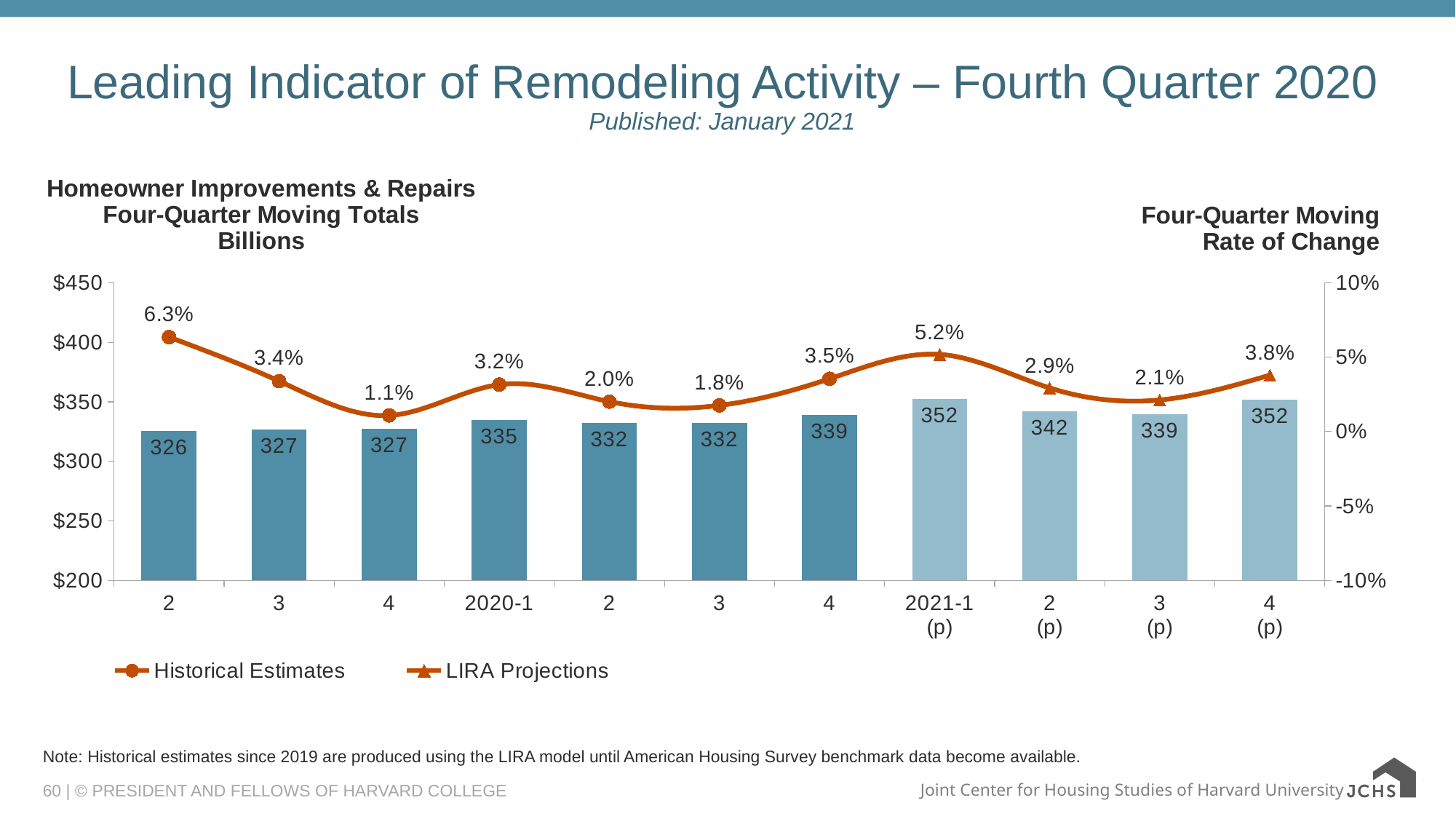
Which is larger, the four-quarter moving total for 2 (p) or for 3 (p)? 2 (p) What is the four-quarter moving rate of change for 2021-1 (p)? 5.2% What is the difference between the four-quarter moving totals for 2021-1 (p) and 2020-1? 17 What are the two series named in the legend? Historical Estimates and LIRA Projections How many quarters (bars) are shown on the chart? 11 What is the difference between the rate of change for 2021-1 (p) and the rate of change for 2 (p)? 2.3% What is the four-quarter moving total (in billions) for 4 (p), the last bar on the chart? 352 How many series does the legend list? 2 Which quarter has the highest four-quarter moving rate of change? 2 (the first quarter shown, 6.3%) Which quarter has the lowest four-quarter moving rate of change? 4 (1.1%) What is the four-quarter moving total (in billions) for 2020-1? 335 What kind of chart is shown on the slide? A combination bar and line chart